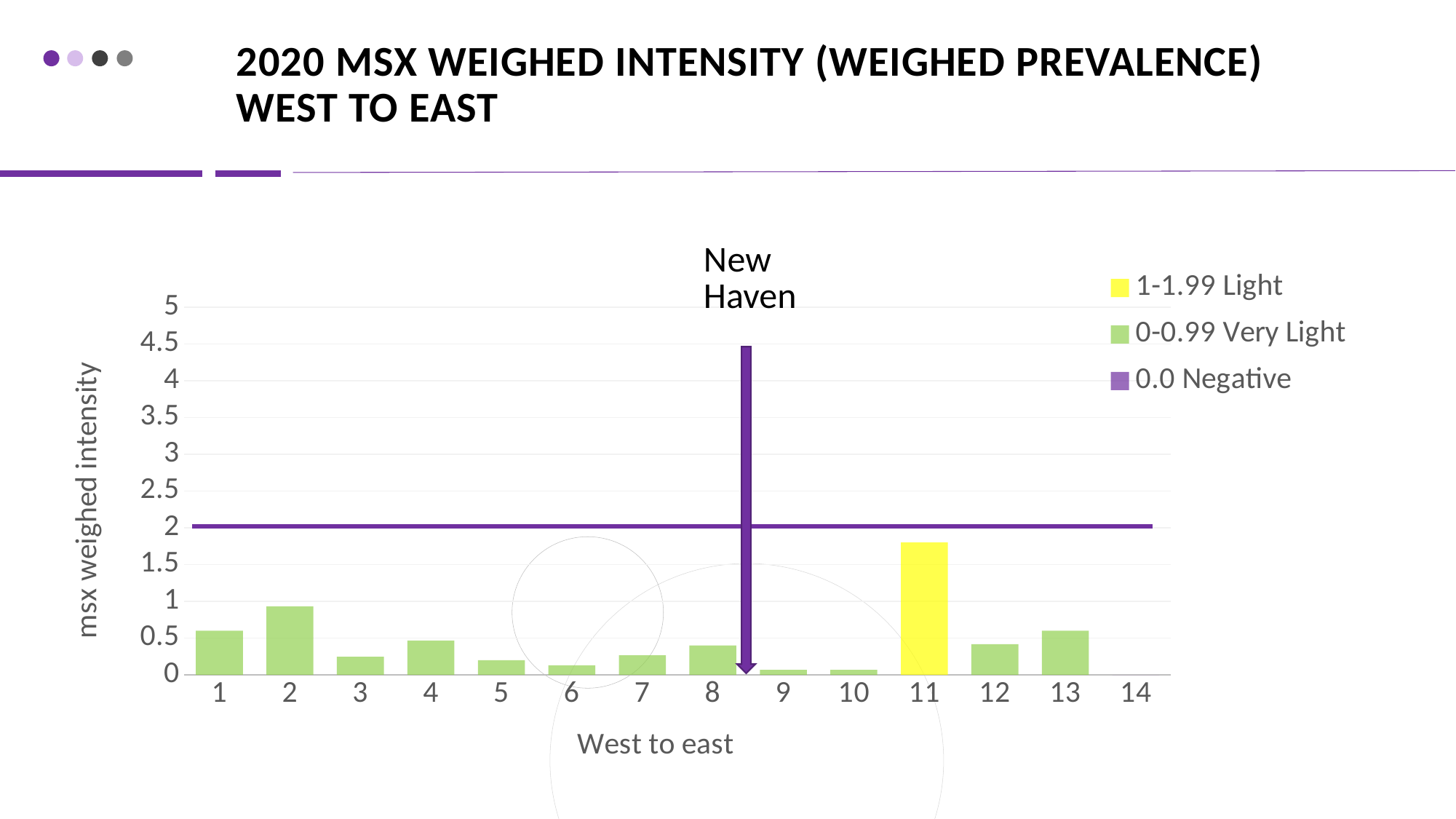
Is the value for category 2 greater or less than 0.5? greater How many entries does the chart's legend list? 3 Which legend entry is shown in yellow? 1-1.99 Light Which category has the highest msx weighed intensity? 11 What kind of chart is shown on the slide? bar chart Is the value for category 9 greater or less than 0.5? less Is the value for category 11 greater or less than 2? less Which has the larger value, category 3 or category 6? 3 Which has the larger value, category 1 or category 2? 2 What is the title of the y axis? msx weighed intensity How many categories are shown along the x axis of the chart? 14